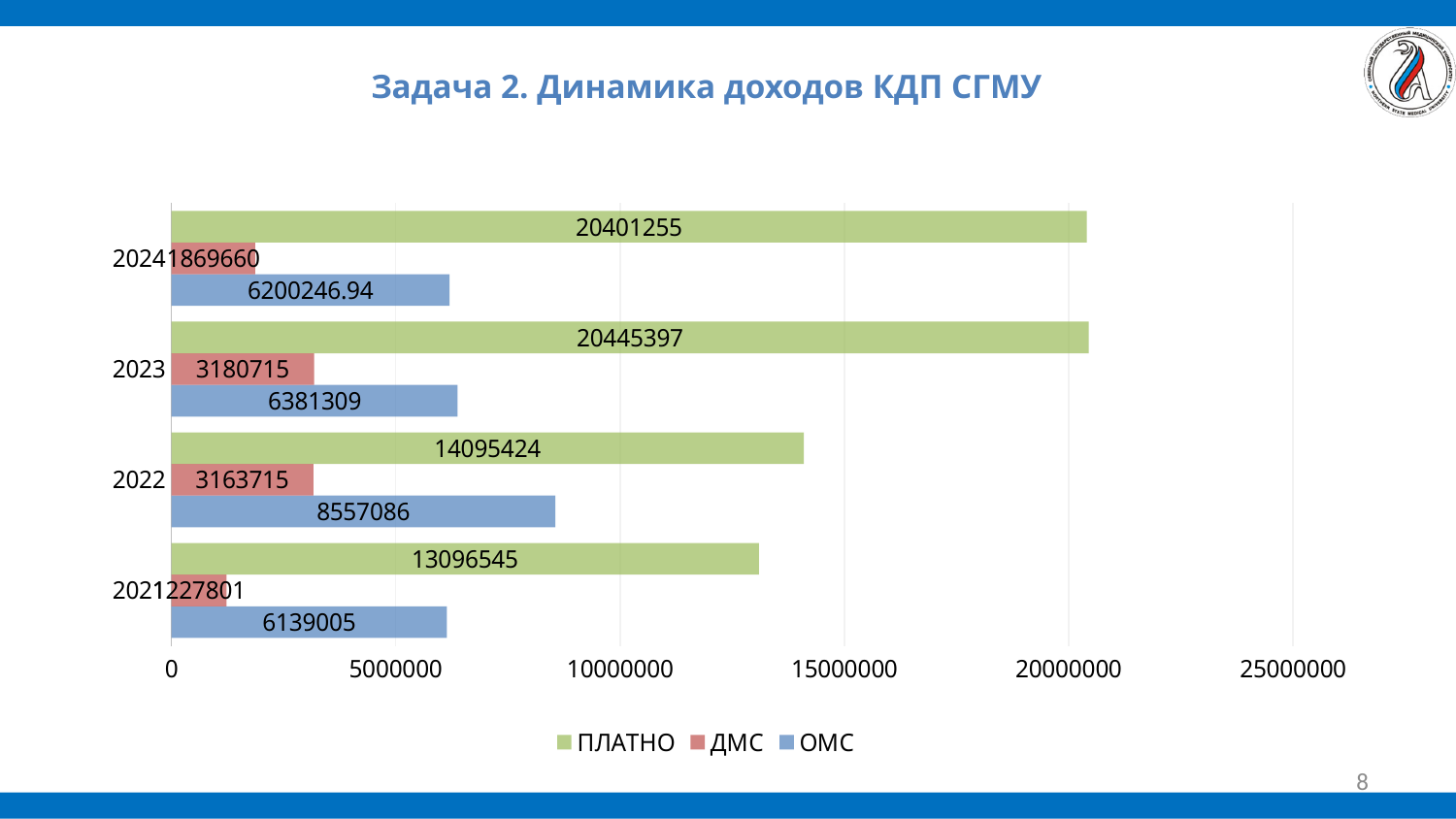
Which is larger, the ДМС value for 2023 or for 2022? 2023 What is the ОМС value for 2022? 8557086 Is the ПЛАТНО value for 2024 greater or less than 20000000? greater What kind of chart is shown on the slide? bar chart What is the ОМС value for 2024? 6200246.94 What is the ПЛАТНО value for 2023? 20445397 What is the difference between the ПЛАТНО values for 2022 and 2021? 998879 How many years are shown on the chart? 4 Which year has the highest ОМС value? 2022 What is the ДМС value for 2023? 3180715 How many series does the legend list? 3 Which year has the lowest ПЛАТНО value? 2021